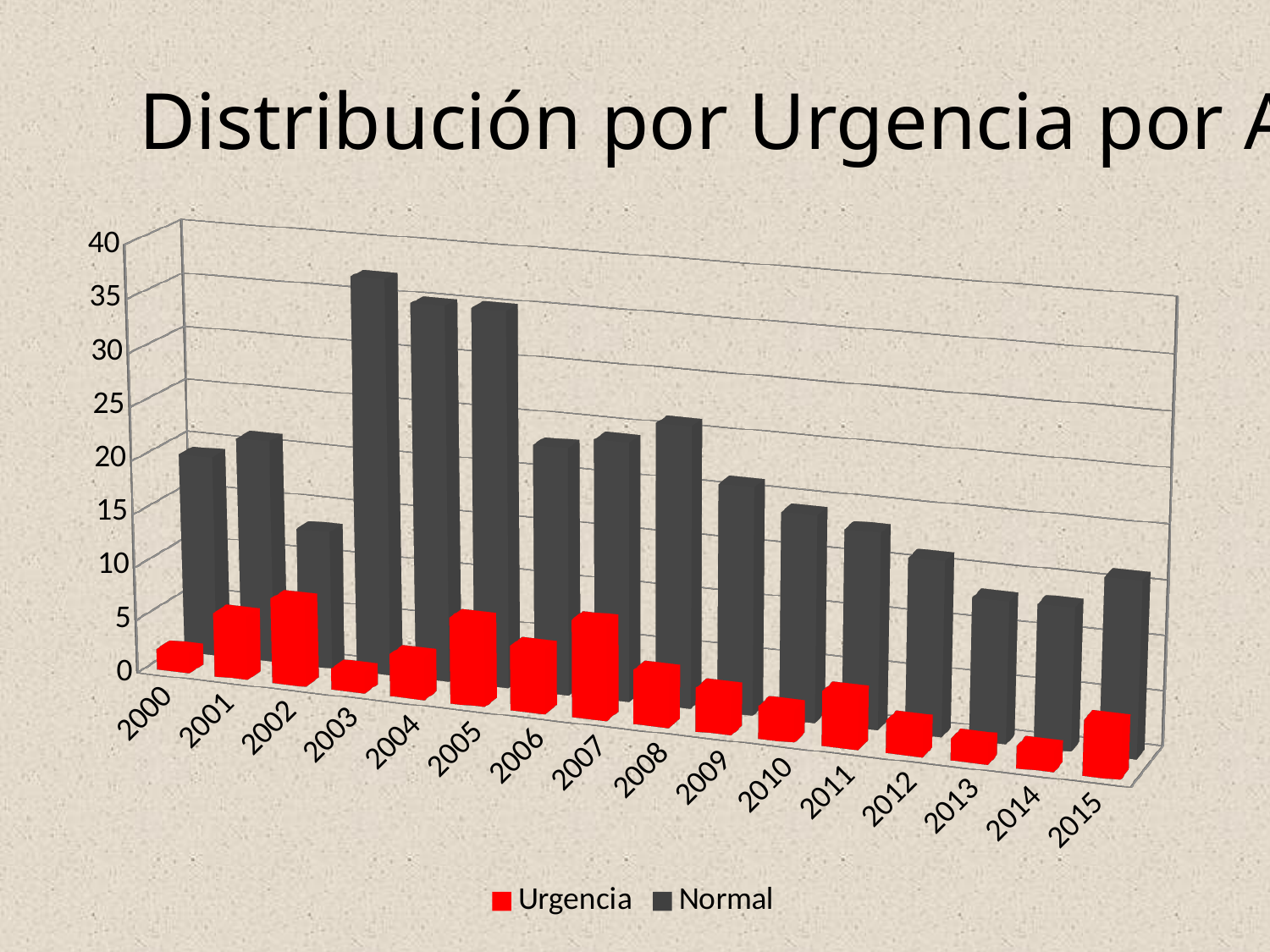
Which year has the highest value for the Normal series? 2003 Is the Normal value for 2003 greater or less than 30? greater What colour represents the Urgencia series? red What kind of chart is shown on the slide? bar chart Is the Normal value for 2000 greater or less than 15? greater Which is larger, the Normal value for 2000 or the Normal value for 2014? 2000 Which year has the highest value for the Urgencia series? 2007 Which is larger, the Normal value for 2003 or the Normal value for 2002? 2003 Do the Normal values rise or fall from 2008 to 2014? fall How many series does the legend list? 2 How many years are shown along the x axis? 16